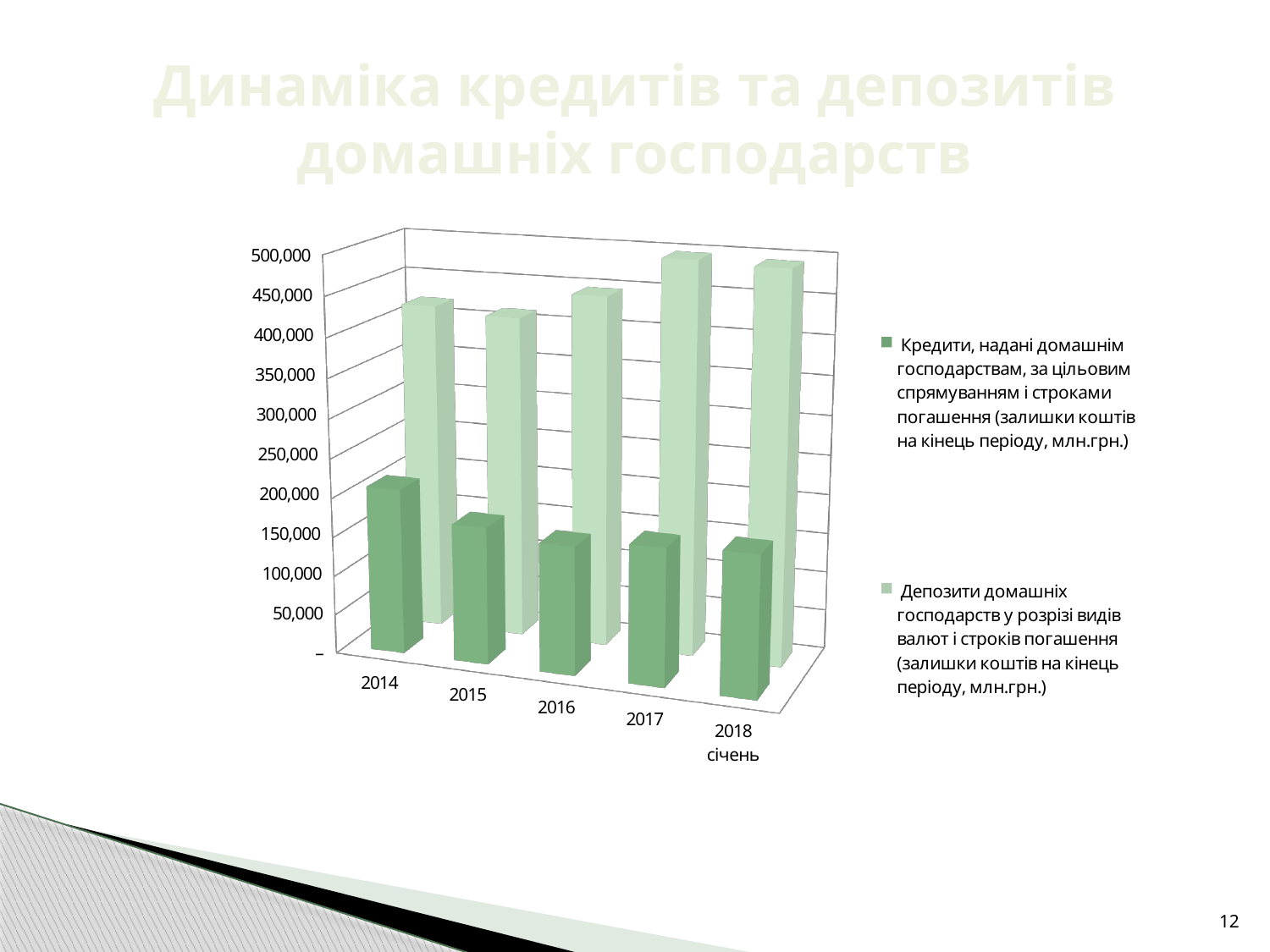
What is the title of the slide containing the chart? Динаміка кредитів та депозитів домашніх господарств Is the credits value for 2014 greater or less than 100,000? greater How many time periods are shown on the x axis? 5 Is the deposits value for 2017 greater or less than 400,000? greater Which period has the highest value for the credits series (Кредити, надані домашнім господарствам)? 2014 Which is larger in 2014: the credits value or the deposits value? deposits Is the deposits value for 2014 greater or less than 300,000? greater How many series does the legend list? 2 Which period has the highest value for the deposits series (Депозити домашніх господарств)? 2017 Do the credits values generally rise or fall from 2014 to 2018 січень? fall What kind of chart is shown on the slide? bar chart